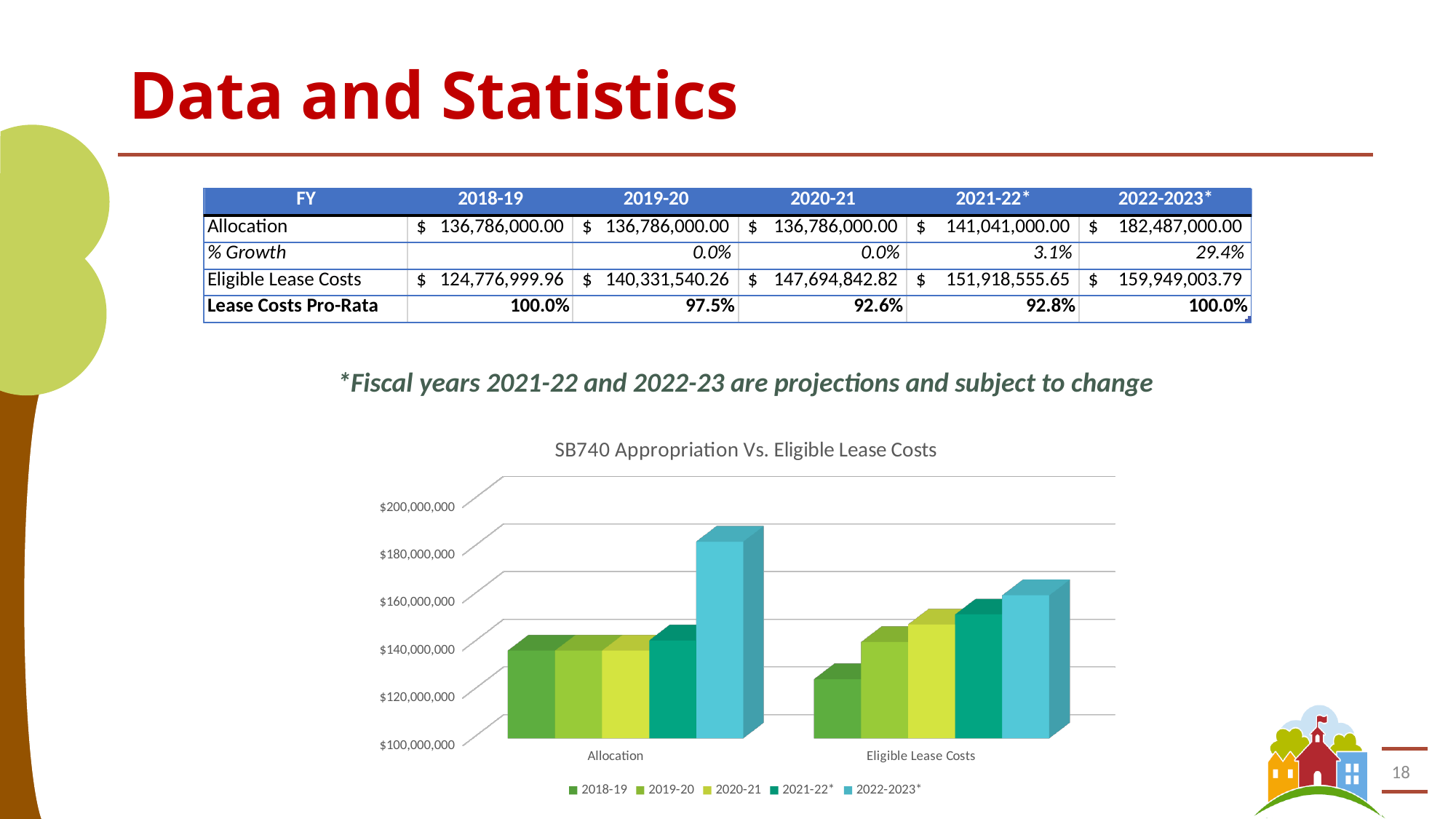
Is the Allocation value for 2022-2023* greater or less than $160,000,000? greater In the Eligible Lease Costs group, which fiscal year has the shortest bar? 2018-19 How many series does the chart legend list? 5 Do the Eligible Lease Costs bars rise or fall from 2018-19 to 2022-2023*? rise How many categories are shown on the x axis of the chart? 2 What type of chart is shown on the slide? bar chart In the Allocation group, which fiscal year has the tallest bar? 2022-2023* For 2022-2023*, which is larger: the Allocation bar or the Eligible Lease Costs bar? Allocation Is the Eligible Lease Costs value for 2021-22* greater or less than $140,000,000? greater Is the Allocation value for 2018-19 greater or less than $160,000,000? less What is the title of the chart? SB740 Appropriation Vs. Eligible Lease Costs